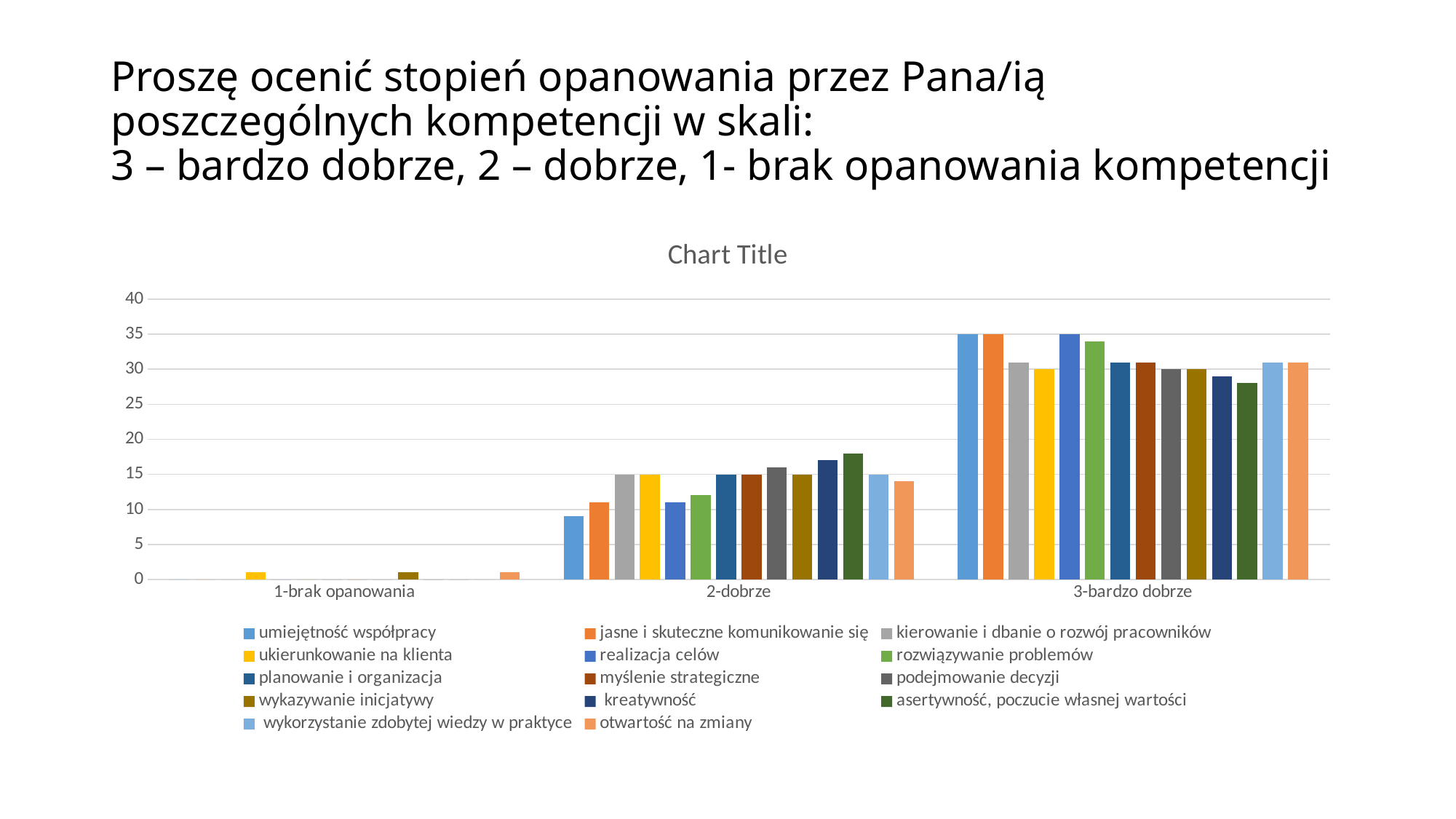
Is the value for umiejętność współpracy in the 2-dobrze category greater or less than 10? less Do the values for umiejętność współpracy rise or fall from 1-brak opanowania to 3-bardzo dobrze? rise In the 2-dobrze category, which is larger: umiejętność współpracy or asertywność, poczucie własnej wartości? asertywność, poczucie własnej wartości What kind of chart is shown on the slide? bar chart Is the value for asertywność, poczucie własnej wartości in the 3-bardzo dobrze category greater or less than 30? less How many series does the chart legend list? 14 Is the value for rozwiązywanie problemów in the 3-bardzo dobrze category greater or less than 30? greater What is the title shown above the chart? Chart Title How many categories are shown on the x axis of the chart? 3 In the 3-bardzo dobrze category, which is larger: umiejętność współpracy or asertywność, poczucie własnej wartości? umiejętność współpracy Which series has the lowest value in the 2-dobrze category? umiejętność współpracy